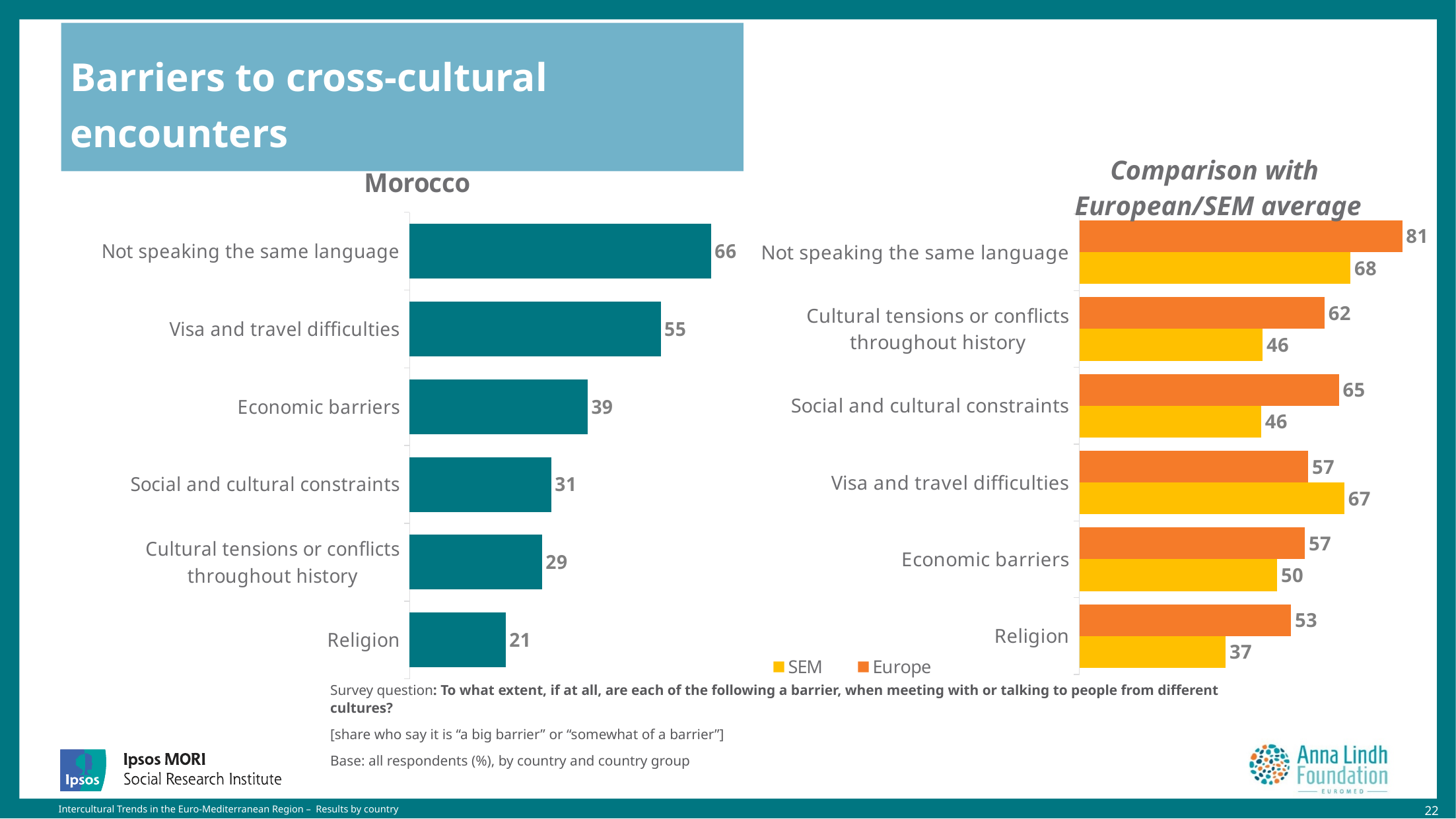
In the Morocco chart, what is the value for Visa and travel difficulties? 55 In the Morocco chart, what is the difference between Not speaking the same language and Economic barriers? 27 In the Morocco chart, which barrier has the lowest value? Religion In the Comparison with European/SEM average chart, which colour represents SEM? Yellow In the Comparison with European/SEM average chart, what is the SEM value for Visa and travel difficulties? 67 What kind of chart is the Morocco chart? bar chart In the Comparison with European/SEM average chart, which is larger for Social and cultural constraints, Europe or SEM? Europe In the Comparison with European/SEM average chart, what is the Europe value for Religion? 53 In the Morocco chart, how many barriers are shown? 6 In the Morocco chart, which barrier has the highest value? Not speaking the same language In the Comparison with European/SEM average chart, what is the difference between the Europe and SEM values for Cultural tensions or conflicts throughout history? 16 In the Comparison with European/SEM average chart, how many series does the legend list? 2